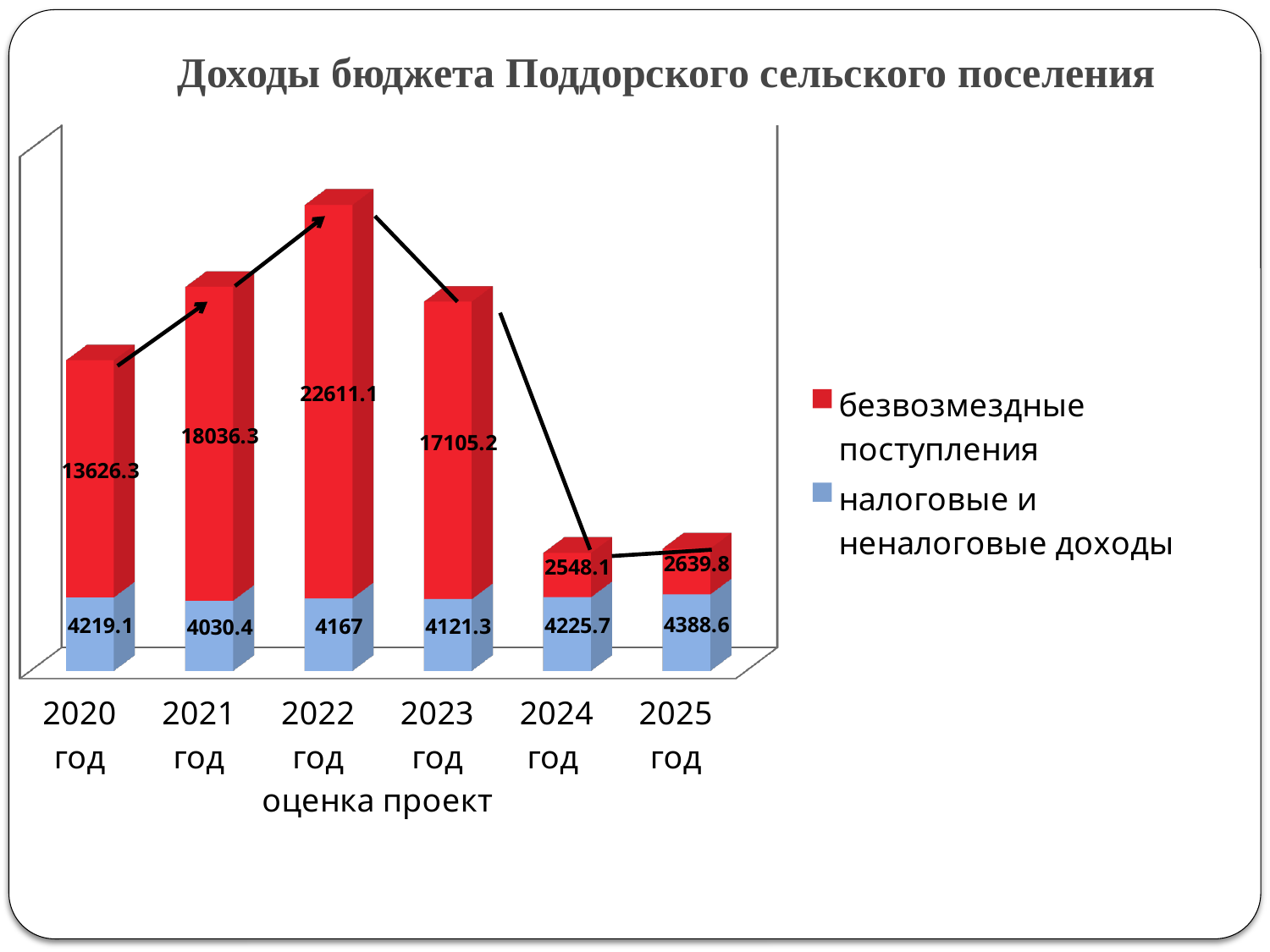
Which is larger: безвозмездные поступления in 2023 год or in 2021 год? 2021 год Which year has the lowest value of безвозмездные поступления? 2024 год What is the difference between безвозмездные поступления in 2022 год and 2021 год? 4574.8 How many series does the legend list? 2 What is the value of налоговые и неналоговые доходы for 2025 год? 4388.6 How many years are shown on the x axis? 6 What is the value of безвозмездные поступления for 2022 год? 22611.1 Which year has the highest value of безвозмездные поступления? 2022 год What is the total of the stacked bar for 2024 год? 6773.8 Which year has the lowest value of налоговые и неналоговые доходы? 2021 год What is the value of безвозмездные поступления for 2024 год? 2548.1 What kind of chart is shown on the slide? Stacked bar chart